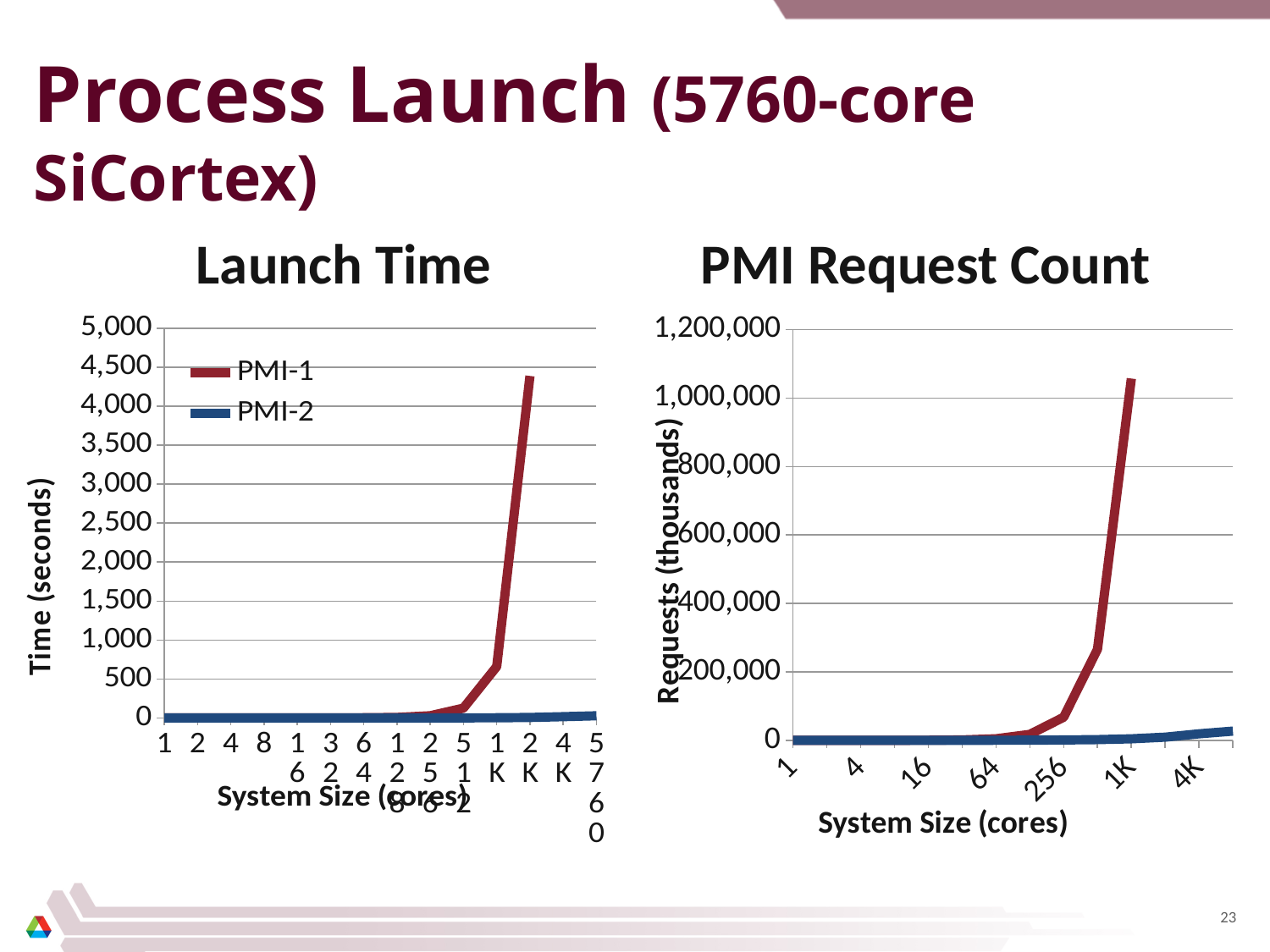
In the Launch Time chart, does the PMI-1 launch time rise or fall as system size increases? rise In the PMI Request Count chart, is the red series value at 1K cores greater or less than 800,000? greater In the PMI Request Count chart, is the blue series value at 4K cores greater or less than 200,000? less In the Launch Time chart, which two series are listed in the legend? PMI-1 and PMI-2 In the Launch Time chart, how many system size categories are shown on the x axis? 14 In the Launch Time chart, is the PMI-1 value at 2K cores greater or less than 4,000? greater In the Launch Time chart, at which system size does PMI-1 reach its highest launch time? 2K How many series does the legend of the Launch Time chart list? 2 What type of chart is the Launch Time chart? line chart In the Launch Time chart, which series has the larger value at 2K cores, PMI-1 or PMI-2? PMI-1